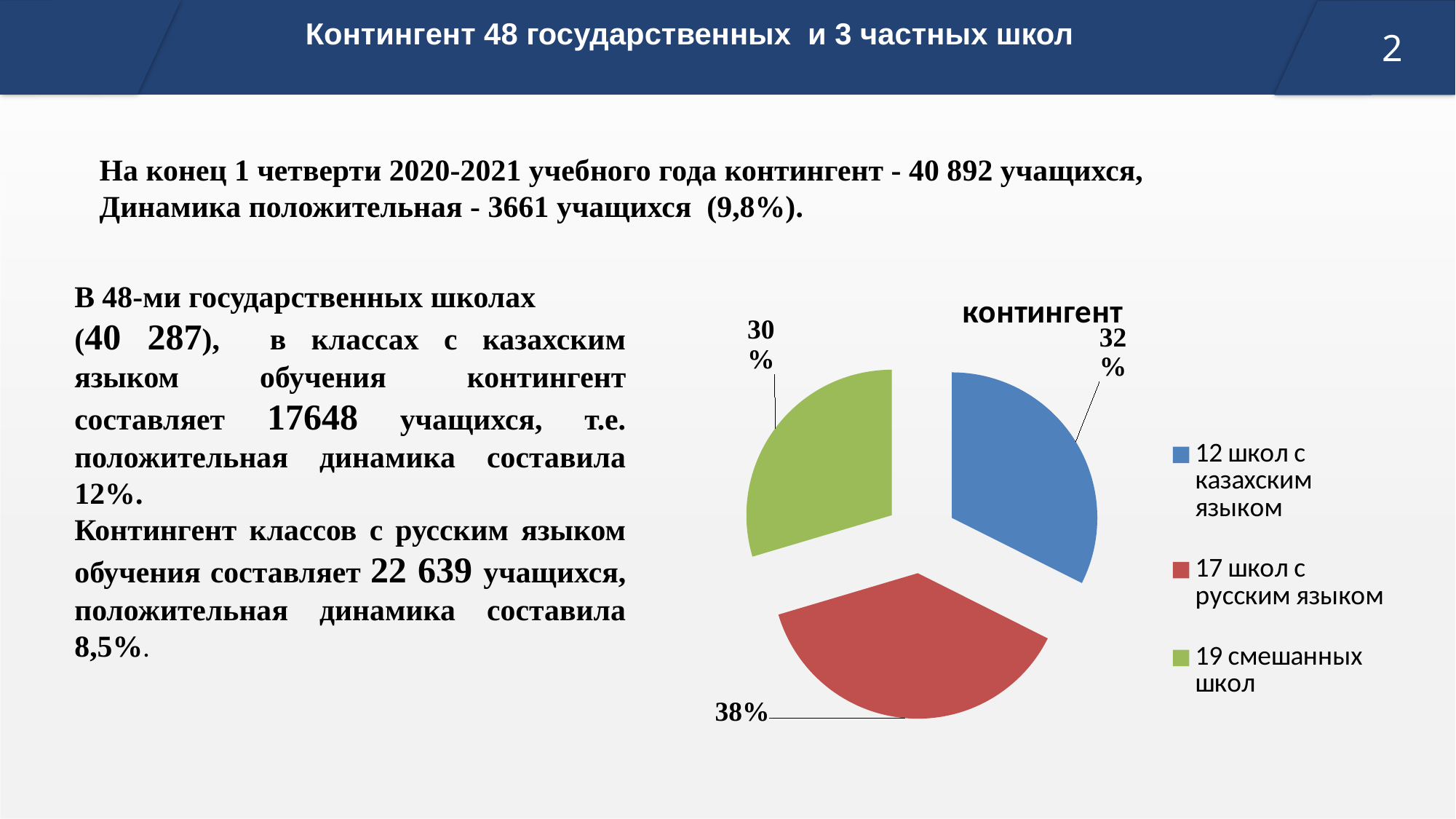
What colour is the slice for '19 смешанных школ' in the pie chart? green What share of the pie does '12 школ с казахским языком' represent? 32% Which category has the smallest slice of the pie chart? 19 смешанных школ How many entries does the legend of the pie chart list? 3 What share of the pie does '17 школ с русским языком' represent? 38% Which slice is larger: '12 школ с казахским языком' or '19 смешанных школ'? 12 школ с казахским языком What is the title of the pie chart? контингент How many slices does the pie chart have? 3 What share of the pie does '19 смешанных школ' represent? 30% What kind of chart is shown on the slide? pie chart What is the difference in percentage points between the slice for '17 школ с русским языком' and the slice for '19 смешанных школ'? 8% Which category has the largest slice of the pie chart? 17 школ с русским языком